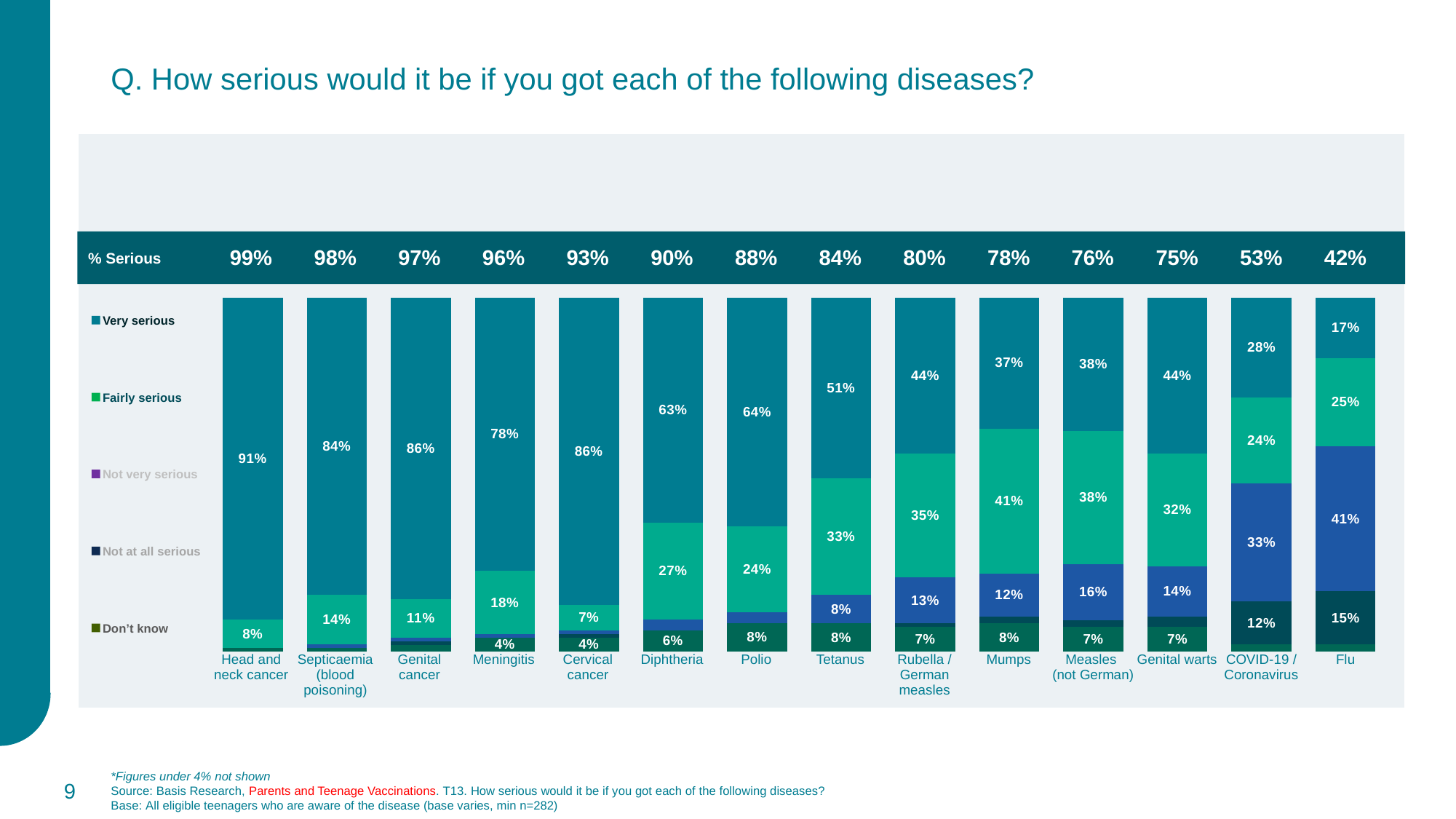
What is the '% Serious' figure shown for Tetanus? 84% Does the '% Serious' figure rise or fall moving from left to right across the diseases? Fall What is the 'Fairly serious' value for Diphtheria? 27% How many series does the legend list? 5 For Mumps, which is larger: the 'Very serious' share or the 'Fairly serious' share? Fairly serious Which disease has the lowest '% Serious' figure? Flu What is the difference in '% Serious' between COVID-19 / Coronavirus and Flu? 11 percentage points What is the 'Very serious' value for Flu? 17% What percentage of respondents rated head and neck cancer as 'Very serious'? 91% How many diseases are shown on the chart? 14 What kind of chart is shown on the slide? Stacked bar chart Which disease has the highest '% Serious' figure? Head and neck cancer